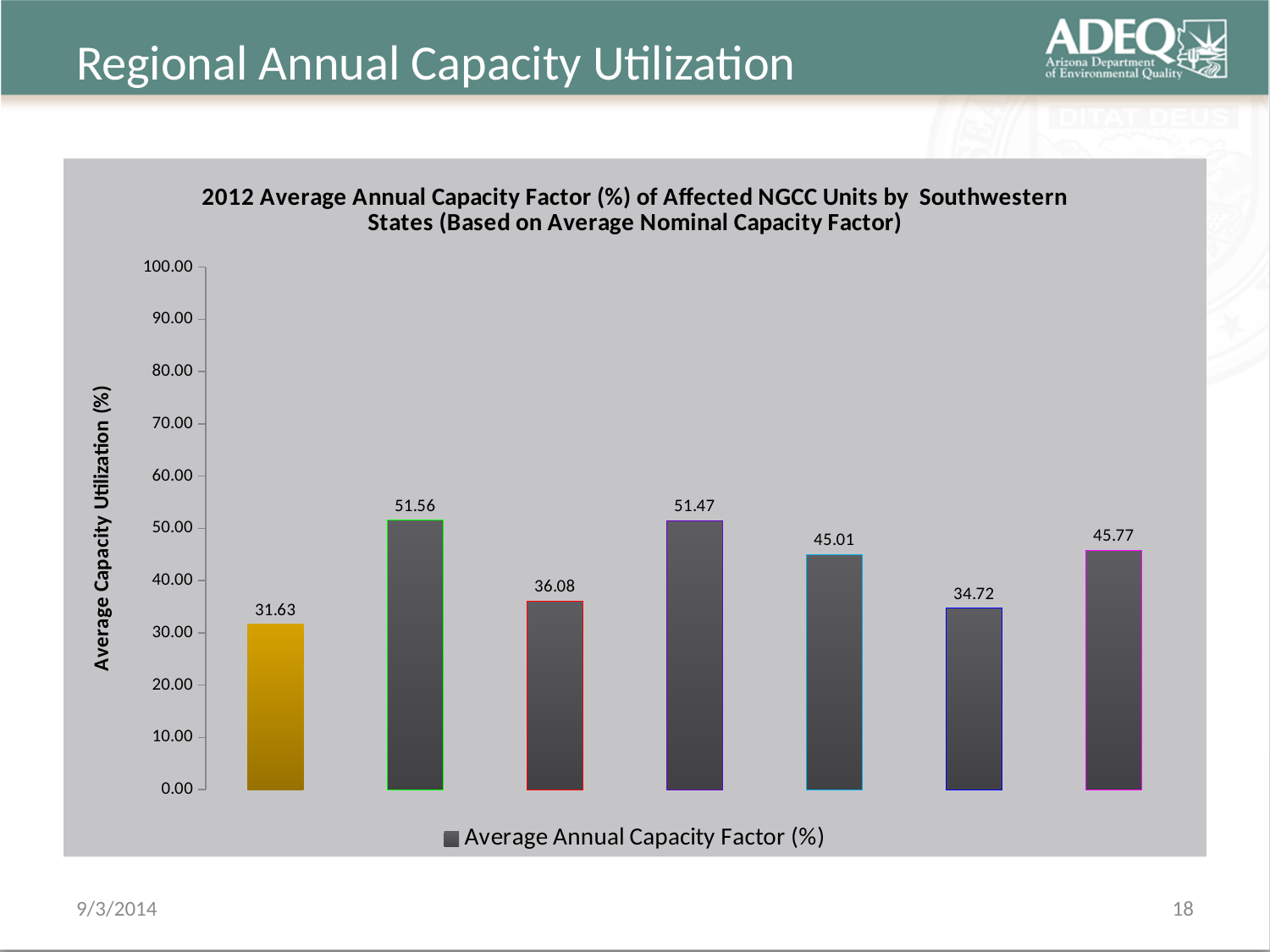
What is the label of the series shown in the legend? Average Annual Capacity Factor (%) What is the highest value shown in the chart? 51.56 Which is larger, the value of the fifth bar (45.01) or the value of the seventh bar (45.77)? 45.77 What is the value of the third bar from the left (with the red outline)? 36.08 What is the lowest value shown in the chart? 31.63 What is the difference between the highest value (51.56) and the lowest value (31.63)? 19.93 What is the value of the leftmost (gold) bar? 31.63 How many bars are plotted in the chart? 7 How many series does the legend list? 1 What type of chart is shown on the slide? bar chart What is the y-axis title of the chart? Average Capacity Utilization (%) What is the value of the rightmost bar (with the magenta outline)? 45.77